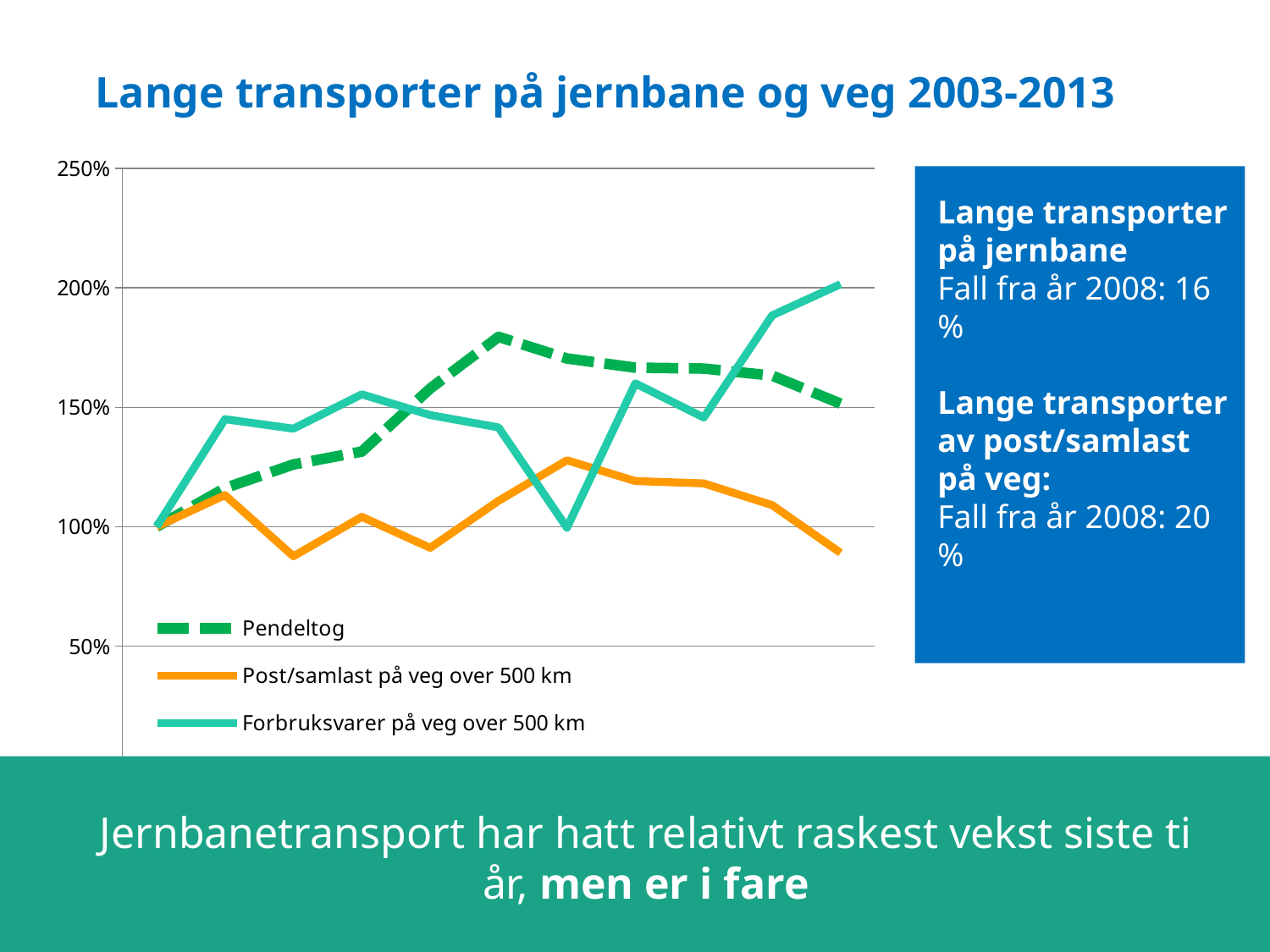
Is the highest value of the Post/samlast på veg over 500 km series greater or less than 150%? less Is the peak value of the Pendeltog series greater or less than 150%? greater Which series has the lowest value at the right end of the chart? Post/samlast på veg over 500 km How many series does the chart legend list? 3 Does the Forbruksvarer på veg over 500 km series end higher or lower than it starts? higher What kind of chart is shown on the slide? line chart Is the final value of the Post/samlast på veg over 500 km series greater or less than 100%? less At the right end of the chart, which is larger: the value for Pendeltog or the value for Forbruksvarer på veg over 500 km? Forbruksvarer på veg over 500 km Which series is drawn with a dashed green line? Pendeltog What is the title of the slide's chart? Lange transporter på jernbane og veg 2003-2013 Which series has the highest value at the right end of the chart? Forbruksvarer på veg over 500 km